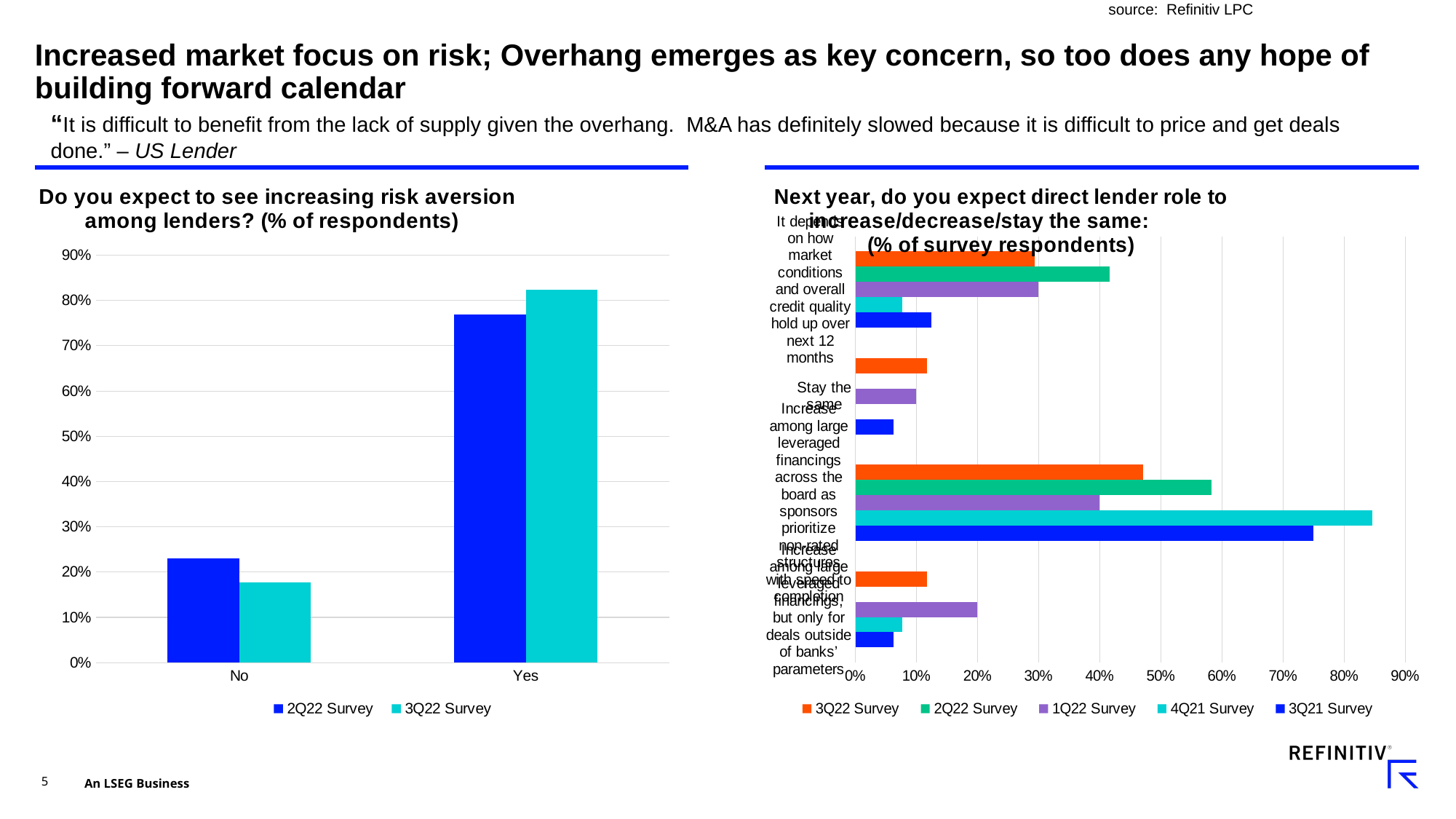
On the right chart 'Next year, do you expect direct lender role to increase/decrease/stay the same', how many series does the legend list? 5 On the left chart 'Do you expect to see increasing risk aversion among lenders?', which response category has the highest value in the 3Q22 Survey? Yes On the left chart 'Do you expect to see increasing risk aversion among lenders?', is the 2Q22 Survey value for 'Yes' greater or less than 80%? less On the left chart 'Do you expect to see increasing risk aversion among lenders?', is the 3Q22 Survey value for 'Yes' greater or less than 80%? greater On the left chart 'Do you expect to see increasing risk aversion among lenders?', which survey has the larger value for 'No', 2Q22 Survey or 3Q22 Survey? 2Q22 Survey On the left chart 'Do you expect to see increasing risk aversion among lenders?', how many series does the legend list? 2 On the left chart 'Do you expect to see increasing risk aversion among lenders?', is the 3Q22 Survey value for 'No' greater or less than 20%? less On the right chart 'Next year, do you expect direct lender role to increase/decrease/stay the same', what kind of chart is shown? bar chart On the left chart 'Do you expect to see increasing risk aversion among lenders?', what kind of chart is shown? bar chart On the left chart 'Do you expect to see increasing risk aversion among lenders?', how many response categories are shown on the x axis? 2 On the left chart 'Do you expect to see increasing risk aversion among lenders?', which survey has the larger value for 'Yes', 2Q22 Survey or 3Q22 Survey? 3Q22 Survey